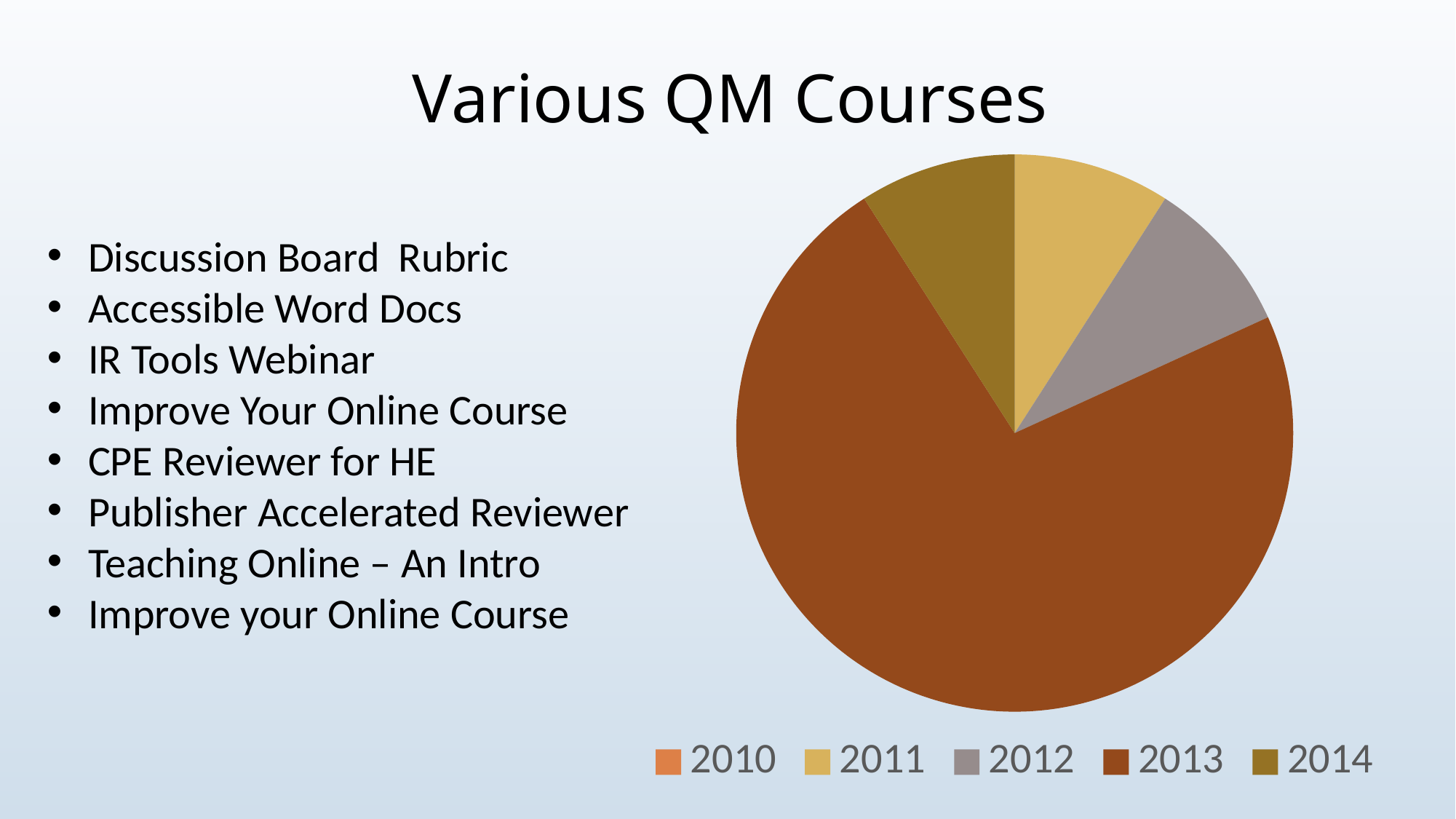
What kind of chart is shown on the slide? pie chart Which year has the largest slice in the pie chart? 2013 How many entries does the pie chart's legend list? 5 What is the title of the slide containing the pie chart? Various QM Courses Which year is represented by the gray slice in the pie chart? 2012 Which slice is larger in the pie chart, 2013 or 2011? 2013 Which slice is larger in the pie chart, 2013 or 2012? 2013 Does the 2013 slice take up more or less than half of the pie chart? more Which slice is larger in the pie chart, 2014 or 2013? 2013 Which years are listed in the pie chart's legend? 2010, 2011, 2012, 2013, 2014